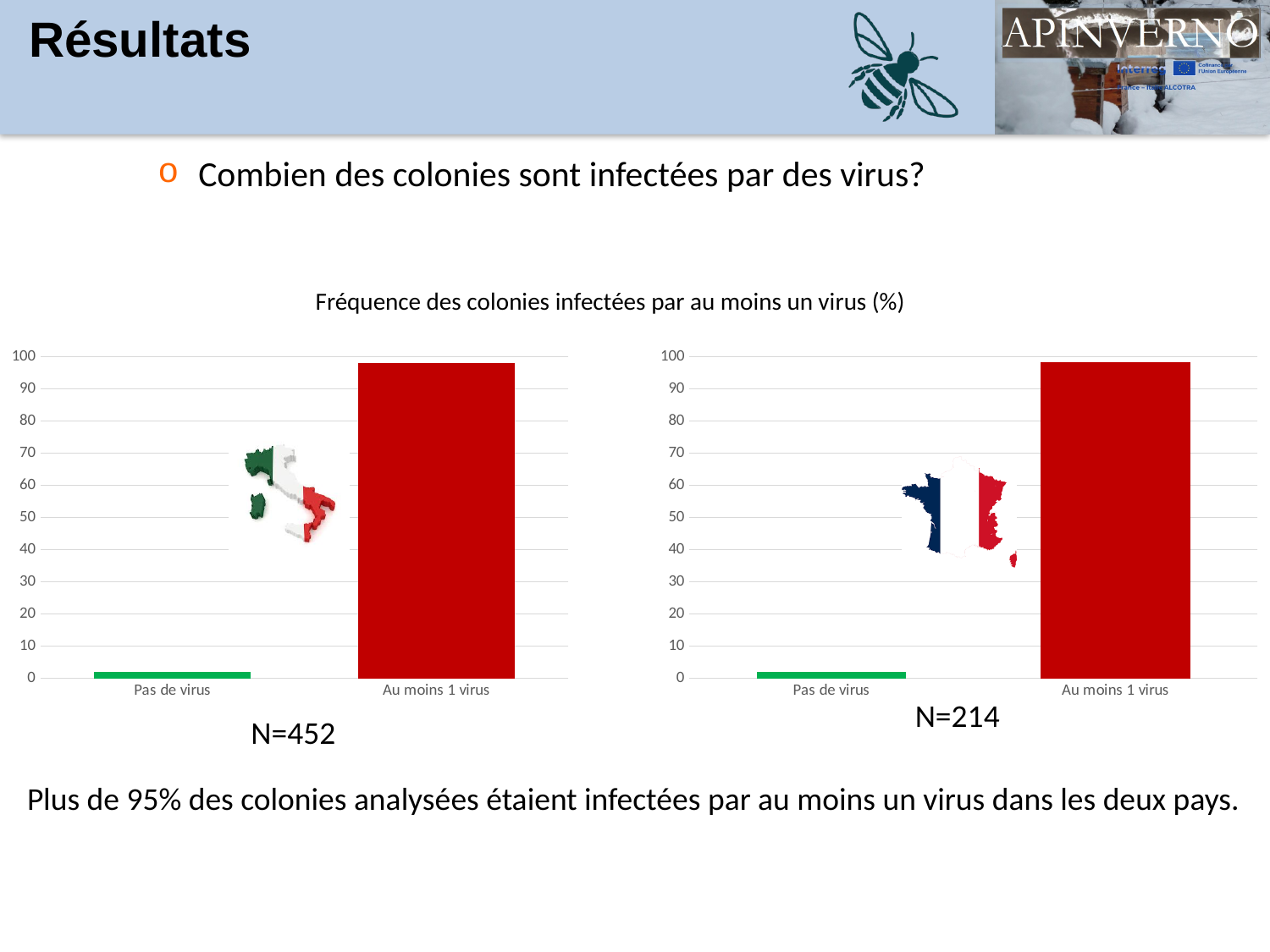
In the left chart (N=452), is the value for Pas de virus greater or less than 10? less In the right chart (N=214), is the value for Pas de virus greater or less than 10? less In the left chart (N=452), is the value for Au moins 1 virus greater or less than 90? greater How many categories does the right chart (N=214) show on its x axis? 2 What is the title shown above the two charts? Fréquence des colonies infectées par au moins un virus (%) What kind of chart is the left chart (N=452)? bar chart In the right chart (N=214), which category has the lowest value? Pas de virus In the right chart (N=214), which is larger, the value for Pas de virus or the value for Au moins 1 virus? Au moins 1 virus In the left chart (N=452), which category has the highest value? Au moins 1 virus What is the sample size (N) given under the right chart? N=214 How many categories does the left chart (N=452) show on its x axis? 2